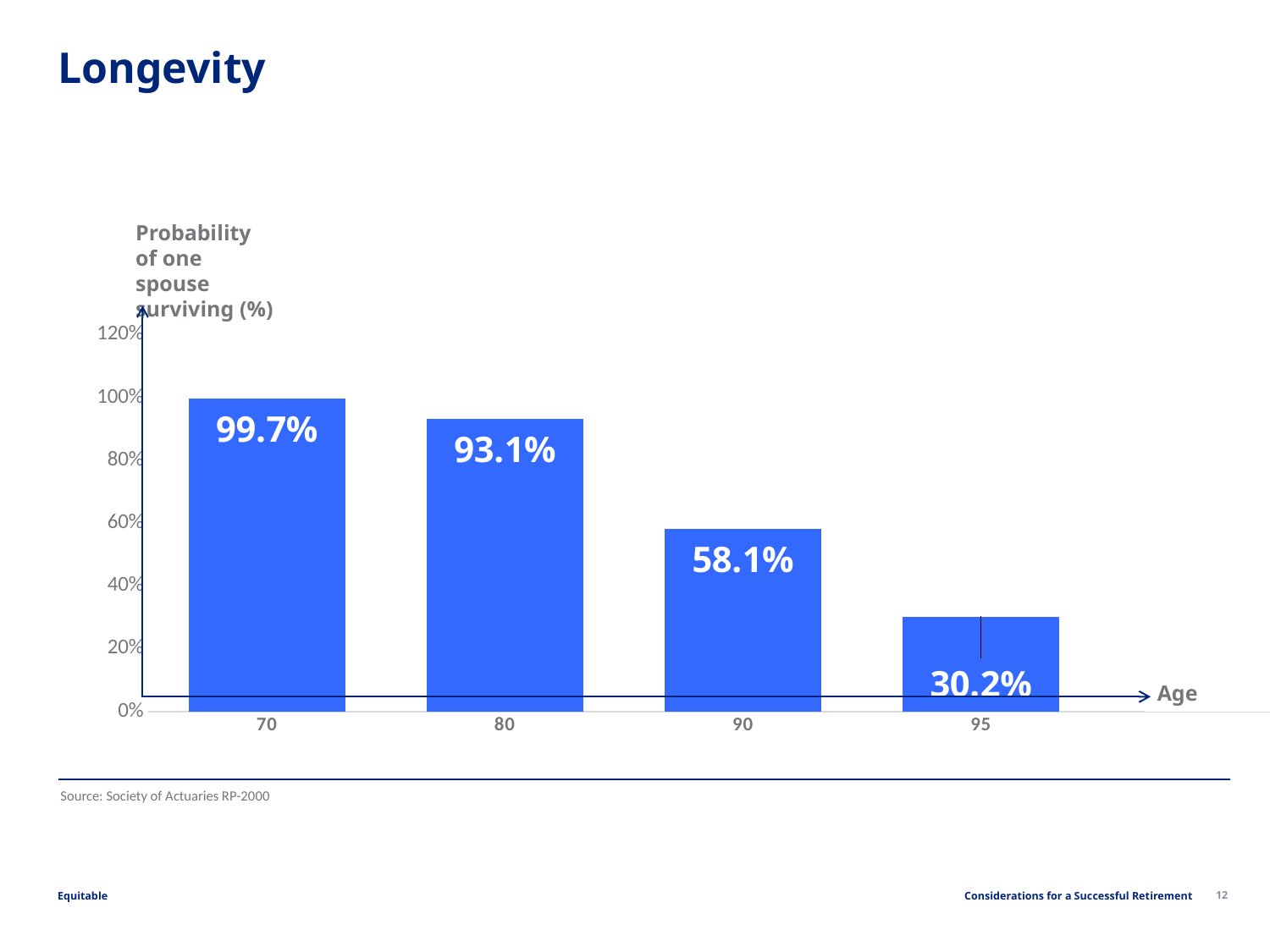
Which age has the highest probability of one spouse surviving? 70 Which is larger, the probability at age 90 or at age 95? 90 Which age has the lowest probability of one spouse surviving? 95 What is the probability of one spouse surviving at age 70? 99.7% What kind of chart is shown on the slide? Bar chart What is the probability of one spouse surviving at age 80? 93.1% What is the probability of one spouse surviving at age 90? 58.1% What is the difference between the probability at age 70 and at age 95? 69.5% How many age categories are shown on the chart? 4 What is the difference between the probability at age 80 and at age 90? 35.0% Do the values rise or fall as age increases along the x axis? Fall What is the probability of one spouse surviving at age 95? 30.2%